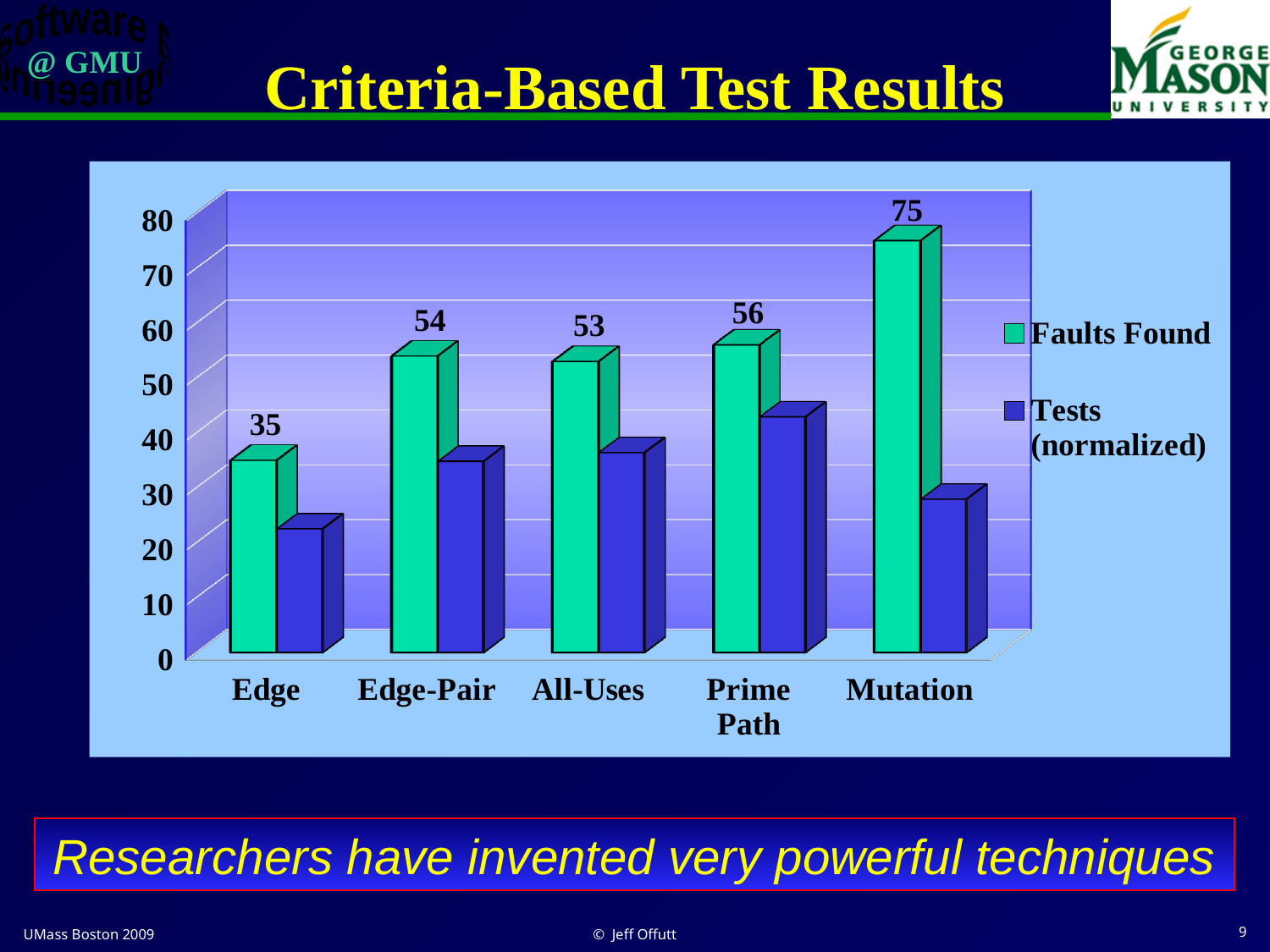
Which category has the highest Faults Found value? Mutation Which category has the lowest Faults Found value? Edge What is the Faults Found value for Prime Path? 56 Is the Tests (normalized) value for Edge greater or less than 30? less Is the Tests (normalized) value for Prime Path greater or less than 30? greater How many series does the legend list? 2 Which has a larger Faults Found value, Edge-Pair or All-Uses? Edge-Pair What kind of chart is shown on the slide? Bar chart What is the difference between the Faults Found values for Mutation and Edge? 40 What is the Faults Found value for Mutation? 75 What is the Faults Found value for Edge? 35 How many categories are shown on the x axis? 5